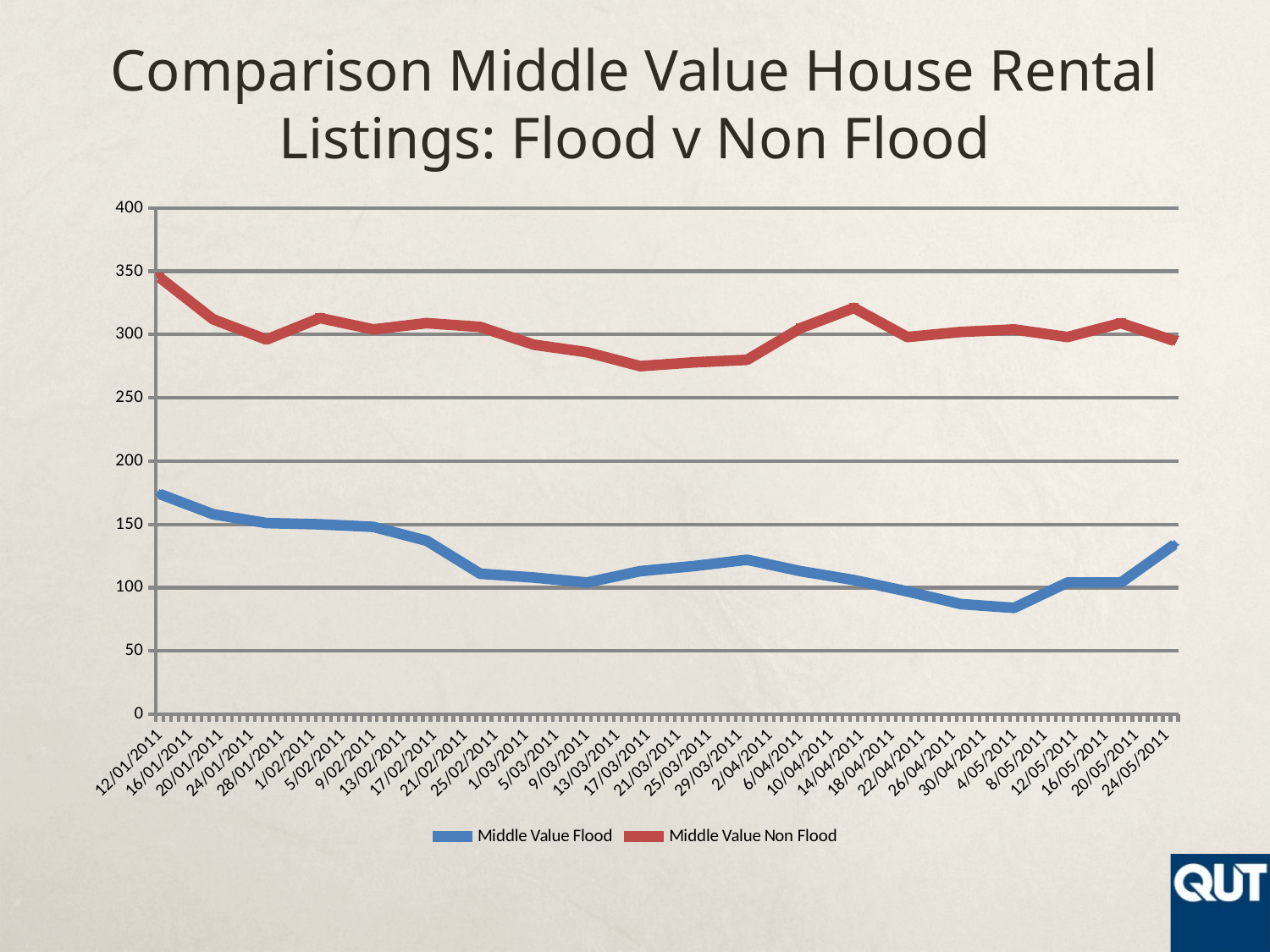
Which colour is used for the Middle Value Non Flood line? red On which date does the Middle Value Non Flood series reach its highest value? 12/01/2011 What are the two series named in the legend? Middle Value Flood and Middle Value Non Flood Is the Middle Value Flood value on 4/05/2011 greater or less than 100? less Does the Middle Value Flood series rise or fall between 12/01/2011 and 25/02/2011? fall What kind of chart is shown on the slide? line chart How many series does the legend list? 2 Is the Middle Value Flood value on 24/05/2011 greater or less than 100? greater Is the Middle Value Flood value on 12/01/2011 greater or less than 150? greater On 2/04/2011, which series has the larger value, Middle Value Flood or Middle Value Non Flood? Middle Value Non Flood